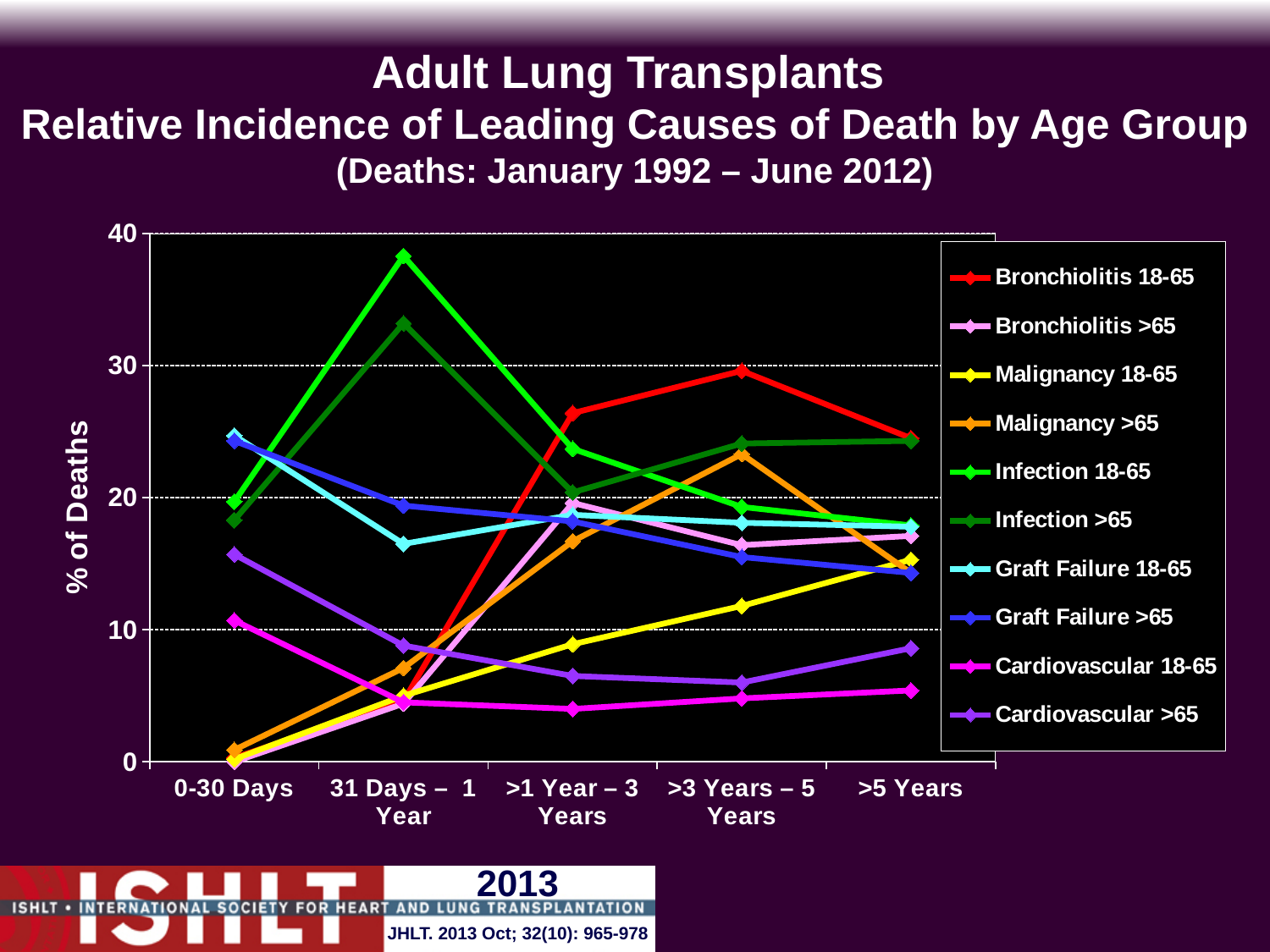
How many time-period categories are shown on the x axis? 5 What kind of chart is shown on the slide? Line chart Which series has the highest value at 31 Days – 1 Year? Infection 18-65 Which series has the lowest value at >5 Years? Cardiovascular 18-65 At 31 Days – 1 Year, which is larger: Infection 18-65 or Infection >65? Infection 18-65 Is the value for Bronchiolitis 18-65 at 0-30 Days greater or less than 10? less How many series does the legend list? 10 Is the value for Cardiovascular 18-65 at >1 Year – 3 Years greater or less than 10? less Which series has the highest value at >3 Years – 5 Years? Bronchiolitis 18-65 Does the Malignancy 18-65 series rise or fall from 0-30 Days to >5 Years? Rise Is the value for Malignancy >65 at >3 Years – 5 Years greater or less than 20? greater